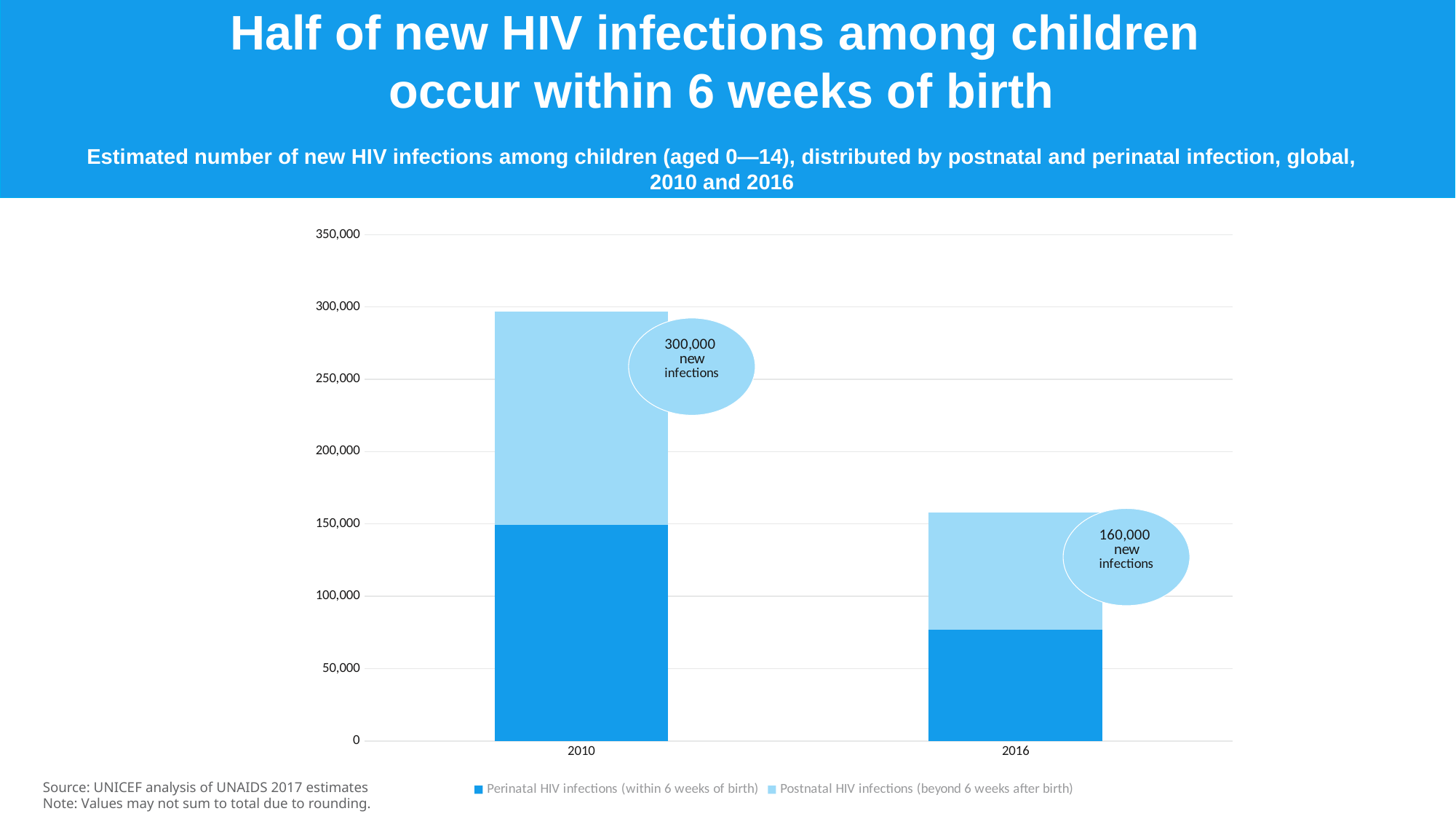
Which year has the higher total number of new HIV infections among children, 2010 or 2016? 2010 Is the value for perinatal HIV infections in 2016 greater or less than 100,000? less Is the value for perinatal HIV infections in 2010 greater or less than 100,000? greater According to the callout label, how many new infections were there in total in 2016? 160,000 What kind of chart is shown on the slide? Stacked bar chart Is the total height of the 2010 bar greater or less than 250,000? greater According to the callout label, how many new infections were there in total in 2010? 300,000 How many series does the chart legend list? 2 Which series is shown in the darker blue colour in the chart? Perinatal HIV infections (within 6 weeks of birth) What is the source cited for the chart data? UNICEF analysis of UNAIDS 2017 estimates How many years (categories) are shown on the x axis of the chart? 2 Do the total new HIV infections among children rise or fall from 2010 to 2016? Fall